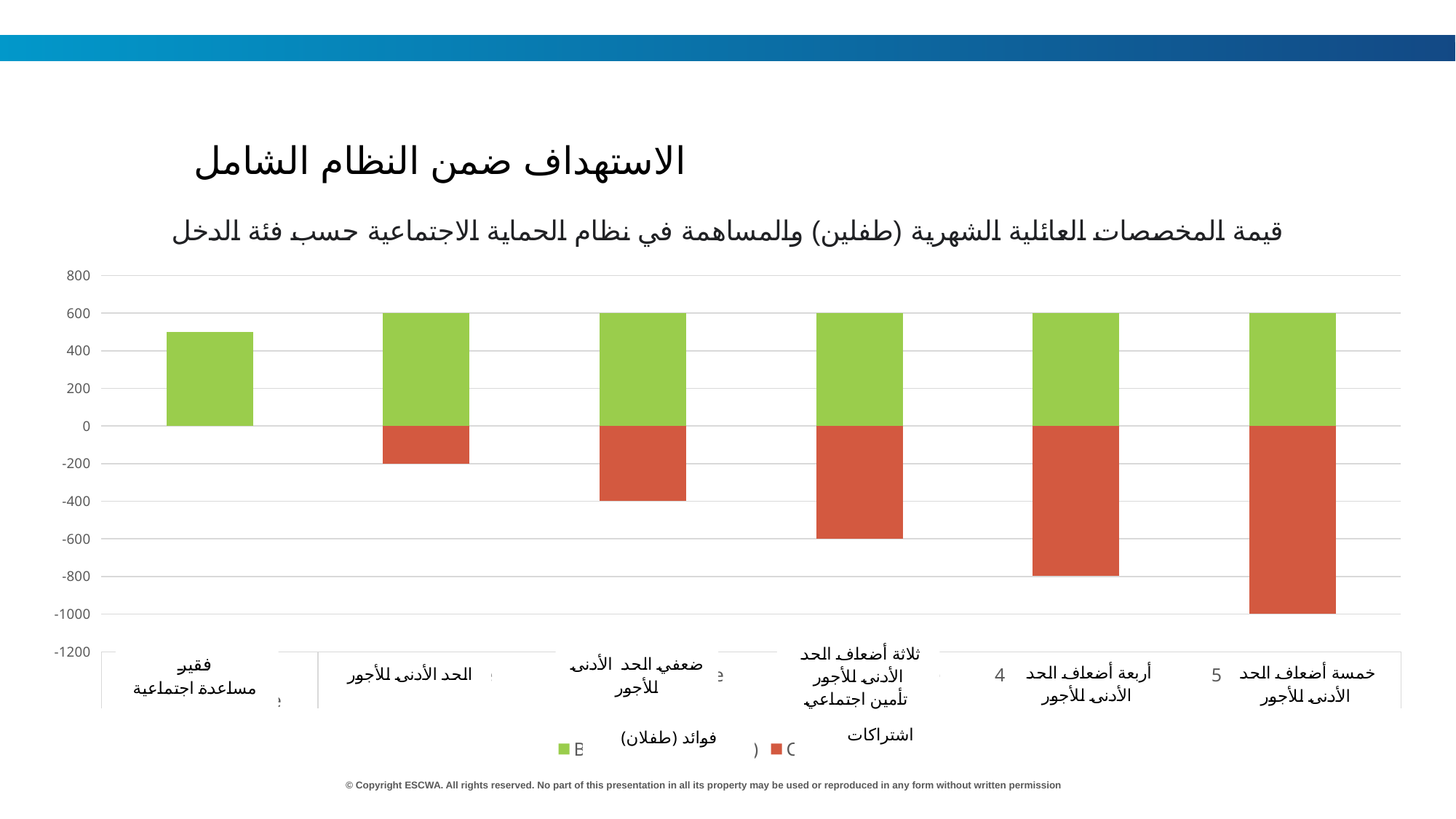
Which category has the lowest (most negative) اشتراكات value? خمسة أضعاف الحد الأدنى للأجور What colour represents the اشتراكات series? red Do the اشتراكات values rise or fall moving from left to right along the x axis? fall Is the فوائد (طفلان) value for فقير مساعدة اجتماعية greater or less than 400? greater How many income categories are shown along the x axis? 6 Which has the larger اشتراكات value, ضعفي الحد الأدنى للأجور or أربعة أضعاف الحد الأدنى للأجور? ضعفي الحد الأدنى للأجور What kind of chart is shown on the slide? bar chart How many series does the legend list? 2 What is the value of فوائد (طفلان) for الحد الأدنى للأجور? 600